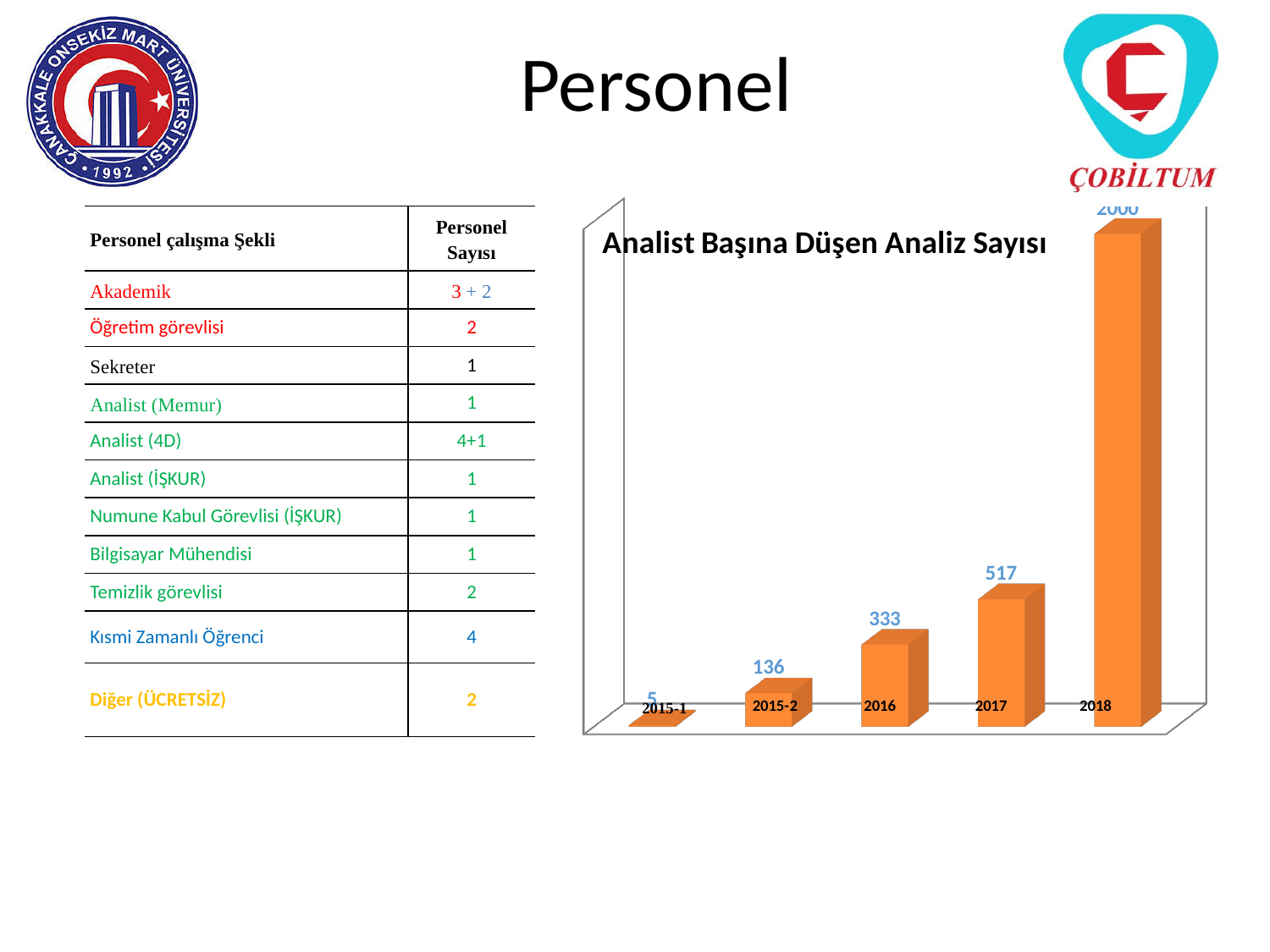
What is the value for 2015-2 in the chart? 136 Which category has the lowest value in the chart? 2015-1 What is the difference between the values for 2016 and 2015-2? 197 Which is larger, the value for 2017 or the value for 2015-2? 2017 What is the value for 2015-1 in the chart? 5 How many categories are shown on the x axis of the chart? 5 What is the difference between the values for 2017 and 2016? 184 Do the values rise or fall from 2015-1 to 2018? Rise What kind of chart is shown on the slide? Bar chart Which category has the highest value in the chart? 2018 What is the value for 2016 in the chart? 333 What is the value for 2017 in the chart? 517